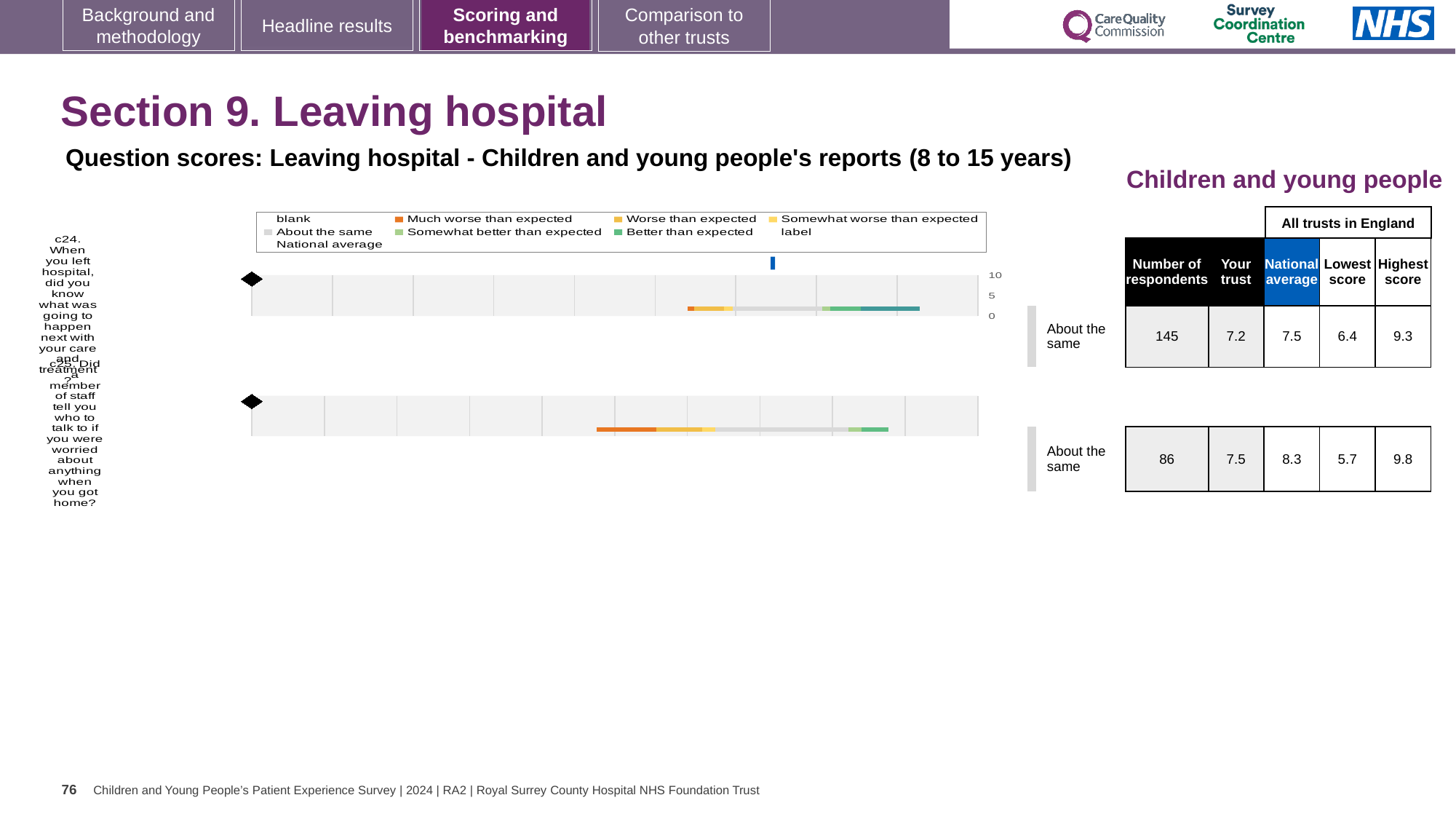
For question c24, which is larger: the 'Your trust' score or the national average? National average How many respondents answered question c24? 145 What colour represents 'Much worse than expected' in the chart legend? Orange How many questions are plotted on the slide? 2 Which question has the higher national average score, c24 or c25? c25 What is the lowest score across all trusts in England for question c24? 6.4 What is the national average score for question c25? 8.3 What kind of chart is used to show the question scores for c24 and c25? bar chart By how much does the national average exceed the 'Your trust' score for question c24? 0.3 What benchmark category is shown for question c24? About the same What is the 'Your trust' score for question c24? 7.2 What is the difference between the highest score and the lowest score for question c25? 4.1